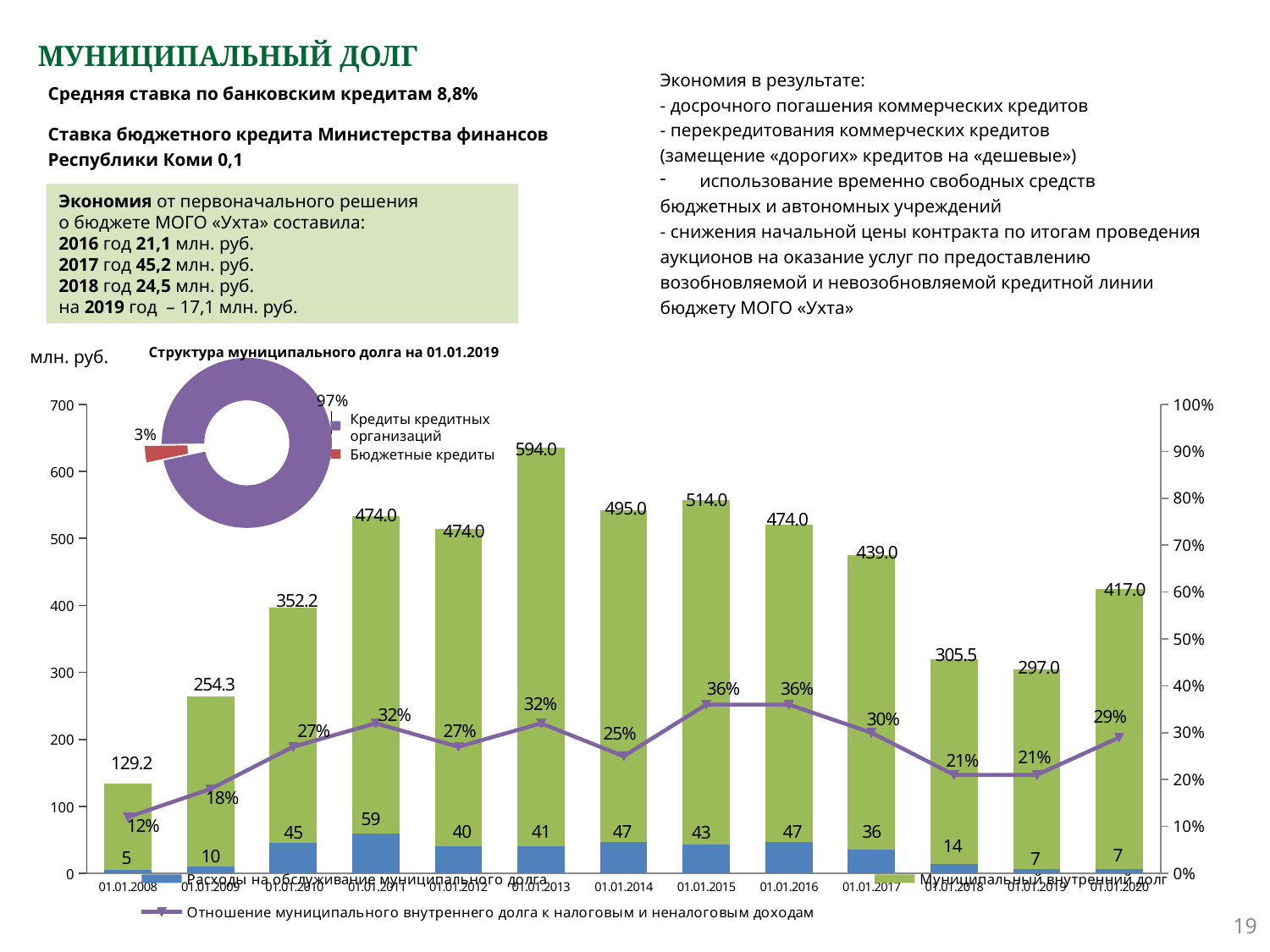
In the 'Структура муниципального долга на 01.01.2019' chart, what share is 'Кредиты кредитных организаций'? 97% In the 'Структура муниципального долга на 01.01.2019' chart, what share is 'Бюджетные кредиты'? 3% How many series does the legend of the large bar chart at the bottom list? 3 In the large bar chart at the bottom, which date has the larger 'Муниципальный внутренний долг': 01.01.2017 or 01.01.2020? 01.01.2017 How many dates are shown on the x axis of the large bar chart at the bottom? 13 In the large bar chart at the bottom, on which date is 'Муниципальный внутренний долг' the lowest? 01.01.2008 In the large bar chart at the bottom, what is the difference in 'Муниципальный внутренний долг' between 01.01.2013 and 01.01.2014? 99.0 In the large bar chart at the bottom, what is the value of 'Отношение муниципального внутреннего долга к налоговым и неналоговым доходам' on 01.01.2015? 36% In the large bar chart at the bottom, on which date is 'Муниципальный внутренний долг' the highest? 01.01.2013 In the large bar chart at the bottom, what is the value of 'Муниципальный внутренний долг' on 01.01.2013? 594.0 In the large bar chart at the bottom, what is the value of 'Расходы на обслуживание муниципального долга' on 01.01.2011? 59 What kind of chart is the 'Структура муниципального долга на 01.01.2019' chart? pie (donut) chart